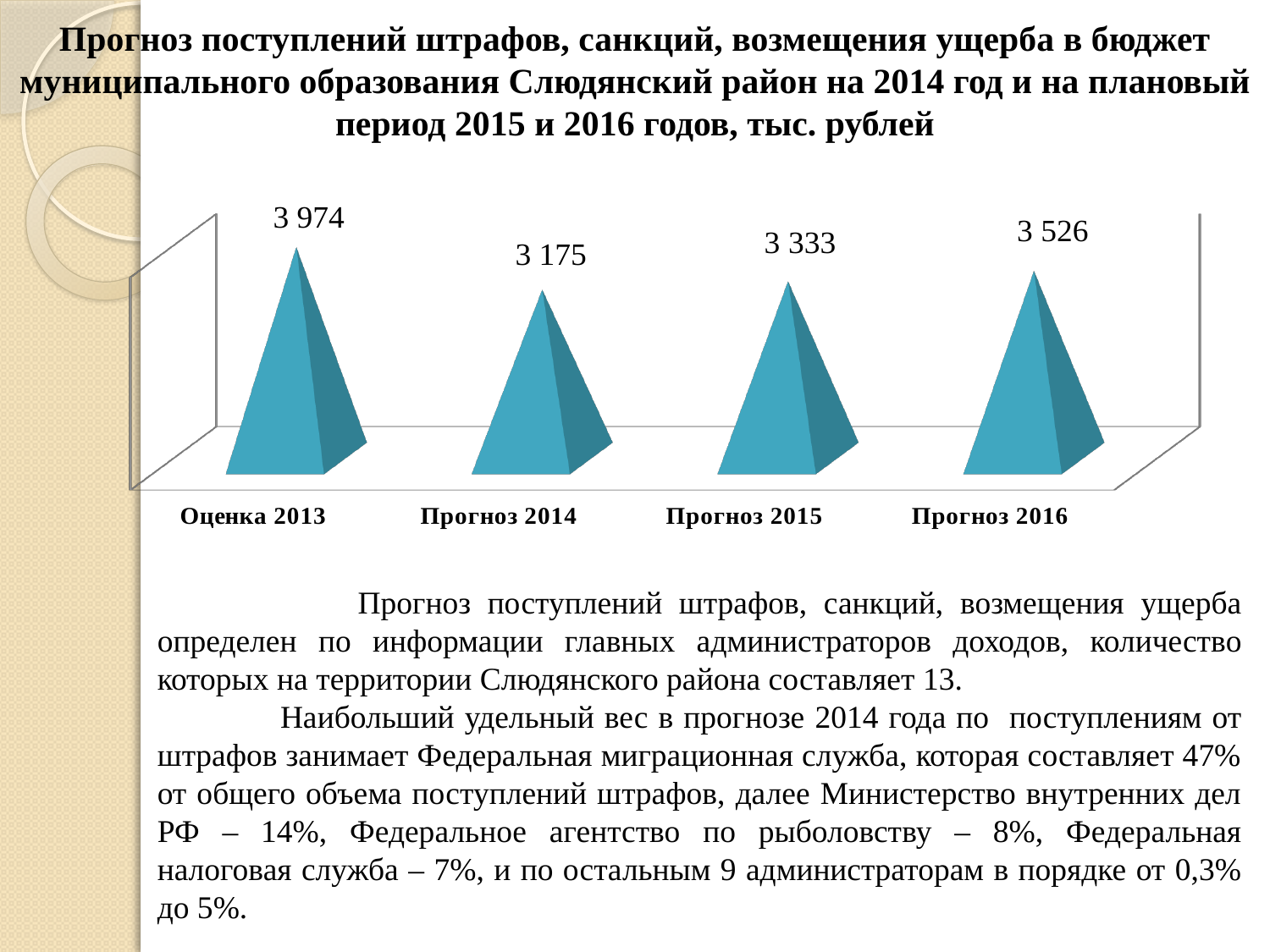
What is the value for Прогноз 2015? 3 333 Which is larger, the value for Прогноз 2015 or the value for Прогноз 2016? Прогноз 2016 What is the value for Прогноз 2016? 3 526 What kind of chart is shown on the slide? Bar chart How many categories are shown on the chart? 4 What is the value for Оценка 2013? 3 974 What is the difference between the values for Оценка 2013 and Прогноз 2014? 799 What is the value for Прогноз 2014? 3 175 Which category has the lowest value? Прогноз 2014 Do the values rise or fall from Прогноз 2014 to Прогноз 2016? Rise Which category has the highest value? Оценка 2013 What is the difference between the values for Прогноз 2016 and Прогноз 2015? 193